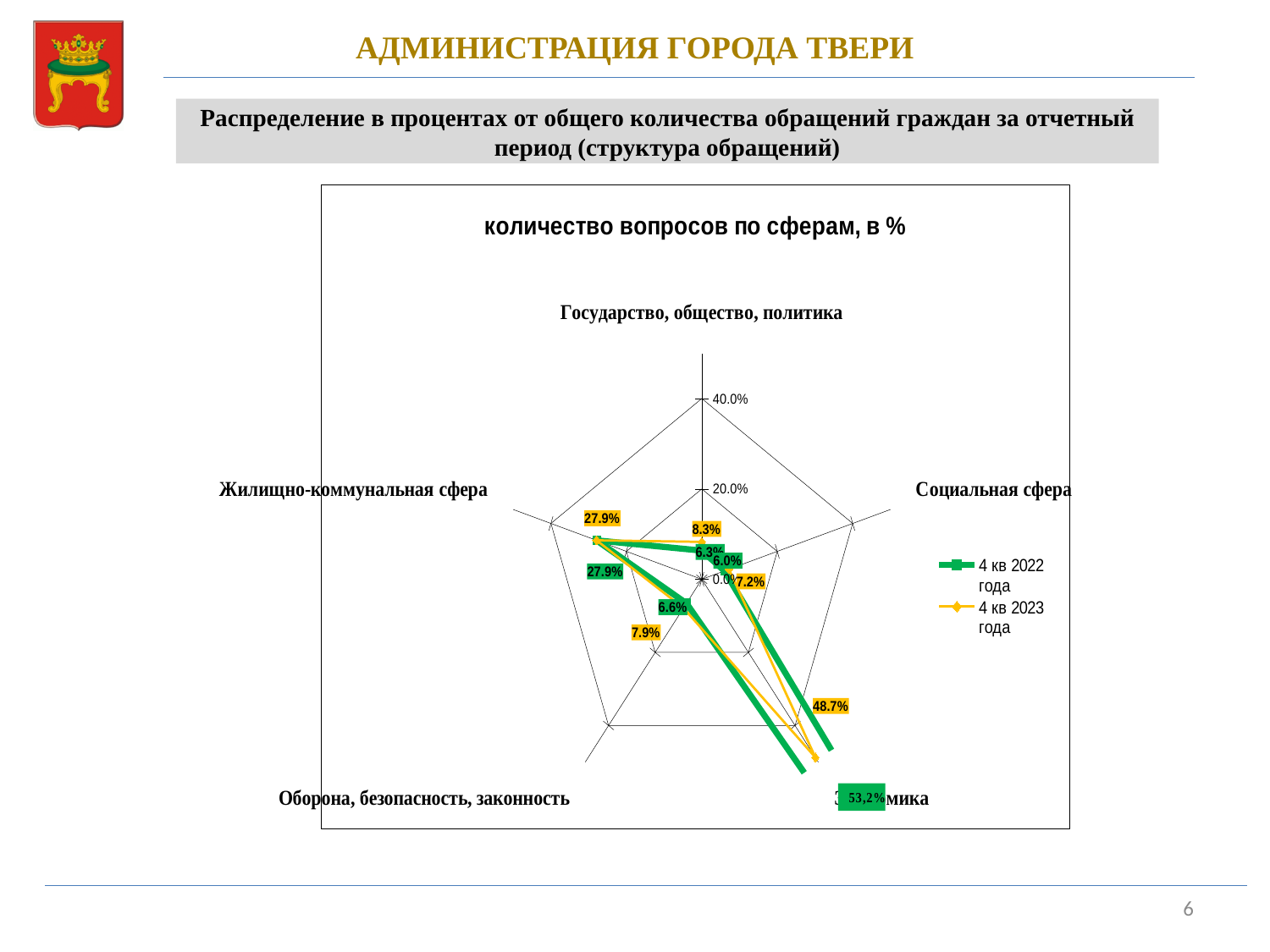
What kind of chart is shown on the slide? radar chart What is the value for Социальная сфера in 4 кв 2022 года? 6.0% What is the value for Государство, общество, политика in 4 кв 2023 года? 8.3% How many categories (axes) does the radar chart have? 5 What is the value for Жилищно-коммунальная сфера in 4 кв 2023 года? 27.9% What is the value for Социальная сфера in 4 кв 2023 года? 7.2% What is the difference between the 4 кв 2023 года and 4 кв 2022 года values for Оборона, безопасность, законность? 1.3% What is the title of the chart? количество вопросов по сферам, в % Which series has the larger value for Оборона, безопасность, законность: 4 кв 2022 года or 4 кв 2023 года? 4 кв 2023 года What is the value for Жилищно-коммунальная сфера in 4 кв 2022 года? 27.9% How many series does the legend list? 2 What is the value for Оборона, безопасность, законность in 4 кв 2023 года? 7.9%